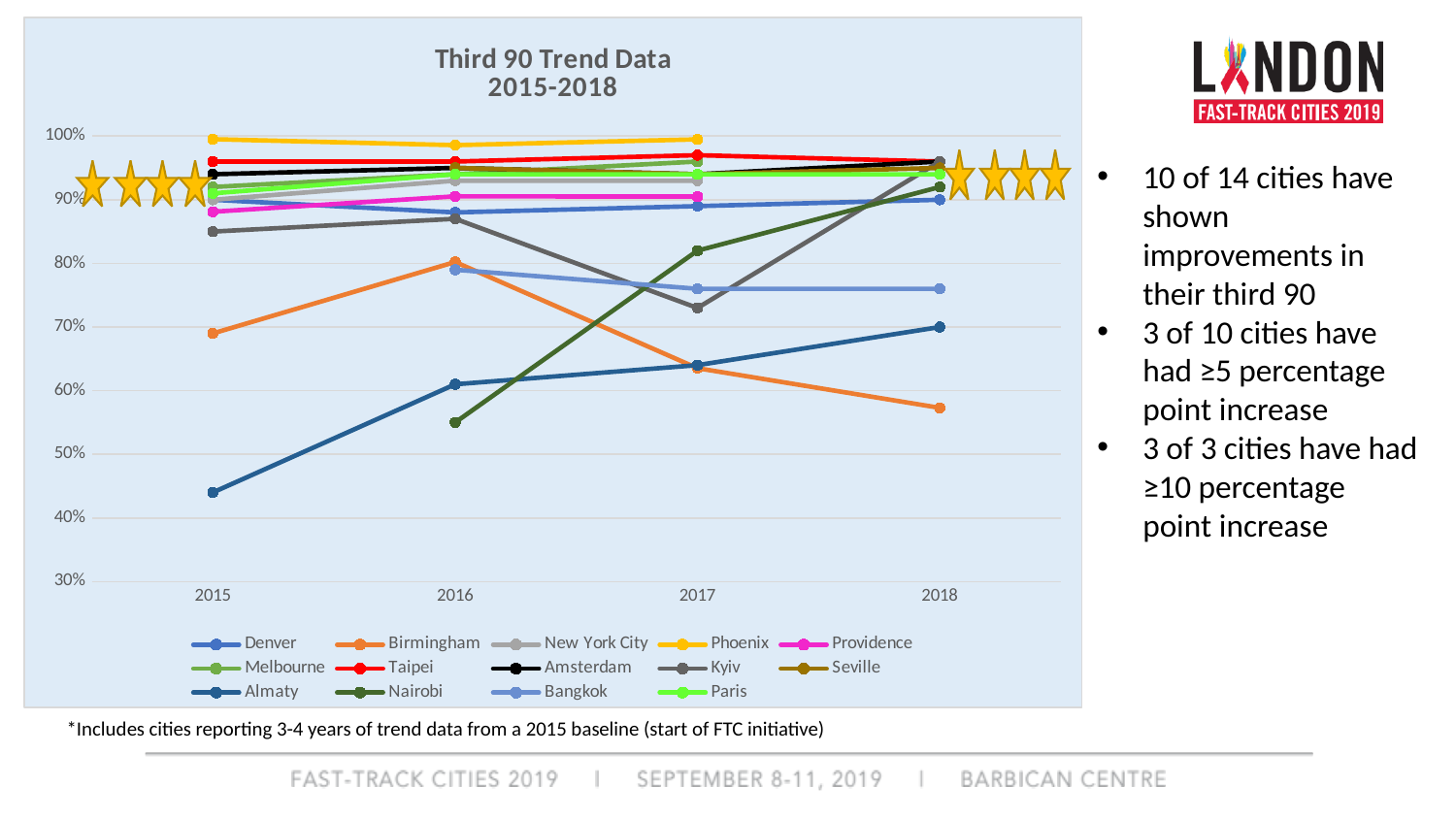
How many series does the chart's legend list? 14 Does the value for Almaty rise or fall from 2015 to 2018? rise Does the value for Birmingham rise or fall from 2016 to 2018? fall Is the value for Kyiv in 2017 greater or less than 80%? less Is the value for Almaty in 2015 greater or less than 50%? less Is the value for Birmingham in 2018 greater or less than 60%? less Which city has the highest value in 2015? Phoenix How many years are shown along the x axis of the chart? 4 Which is larger in 2018, the value for Nairobi or the value for Bangkok? Nairobi What kind of chart is shown on the slide? line chart What is the title of the chart? Third 90 Trend Data 2015-2018 Which city has the lowest value in 2015? Almaty